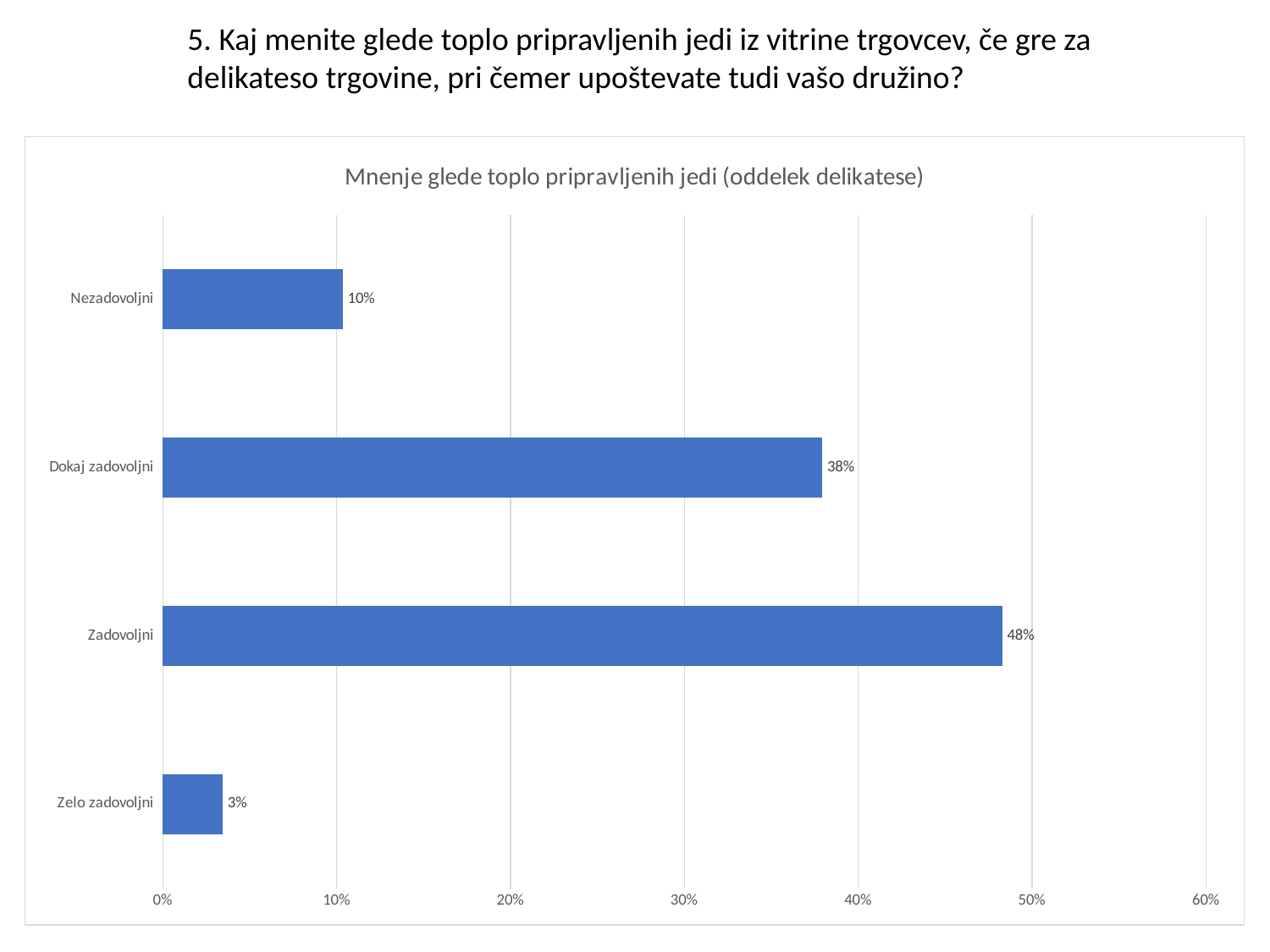
What kind of chart is shown on the slide? bar chart What is the value for Nezadovoljni? 10% What is the value for Dokaj zadovoljni? 38% Which category has the lowest value? Zelo zadovoljni Which category has the highest value? Zadovoljni What is the title of the chart? Mnenje glede toplo pripravljenih jedi (oddelek delikatese) How many categories are shown in the chart? 4 What is the value for Zadovoljni? 48% Is the value for Dokaj zadovoljni greater or less than 40%? less What is the difference between the values for Zadovoljni and Dokaj zadovoljni? 10% What is the value for Zelo zadovoljni? 3% Which is larger, the value for Nezadovoljni or the value for Zelo zadovoljni? Nezadovoljni